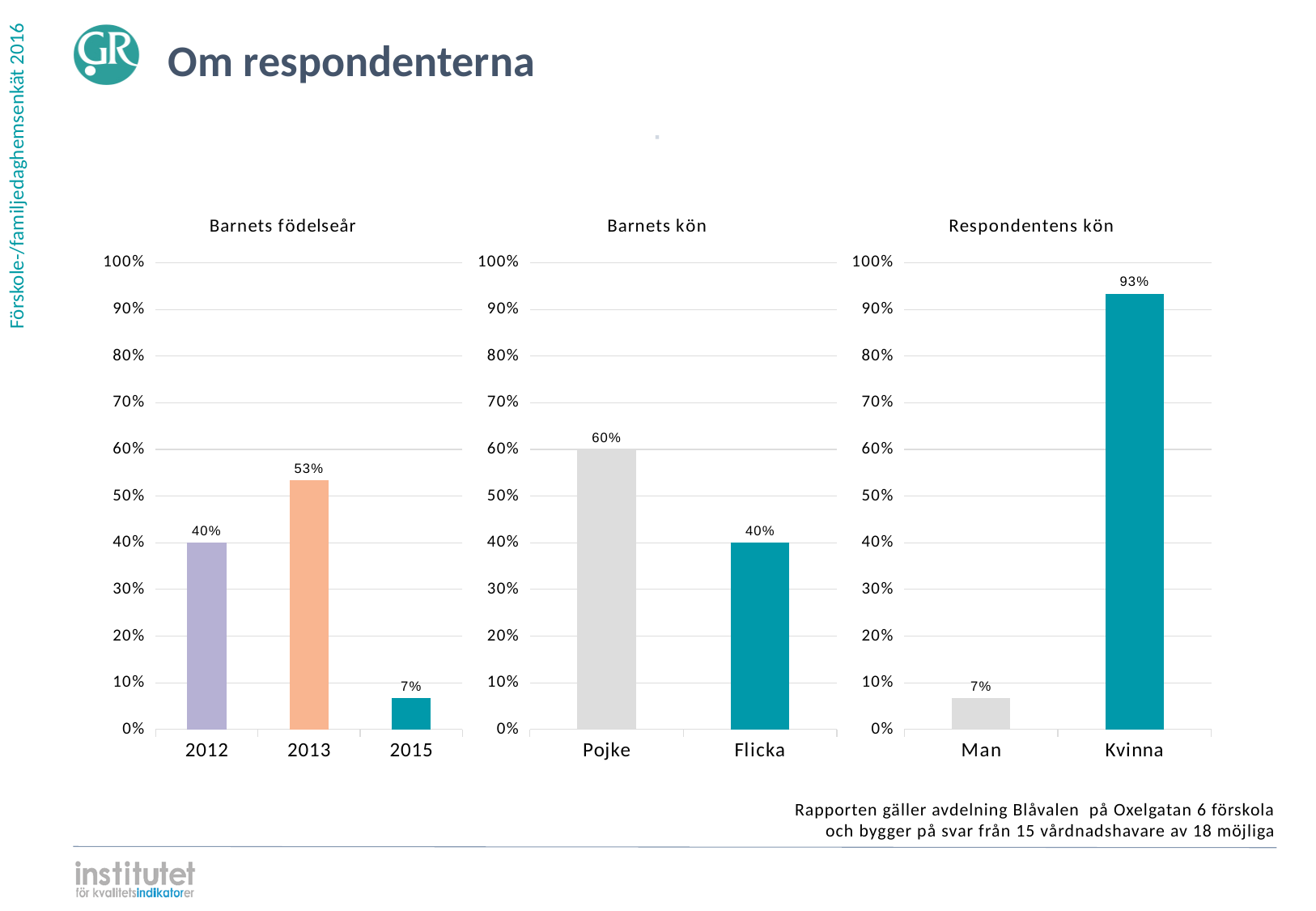
What kind of chart is the 'Barnets kön' chart? Bar chart In the 'Barnets födelseår' chart, what is the difference between the values for 2013 and 2012? 13% How many charts are shown on the slide? 3 In the 'Respondentens kön' chart, what is the value for Man? 7% In the 'Respondentens kön' chart, what is the value for Kvinna? 93% In the 'Barnets födelseår' chart, which year has the lowest value? 2015 In the 'Barnets födelseår' chart, how many categories are shown on the x axis? 3 In the 'Respondentens kön' chart, which category has the highest value? Kvinna In the 'Barnets kön' chart, what is the value for Pojke? 60% In the 'Barnets kön' chart, what is the difference between Pojke and Flicka? 20% In the 'Barnets kön' chart, which is larger, Pojke or Flicka? Pojke In the 'Barnets födelseår' chart, what is the value for 2013? 53%